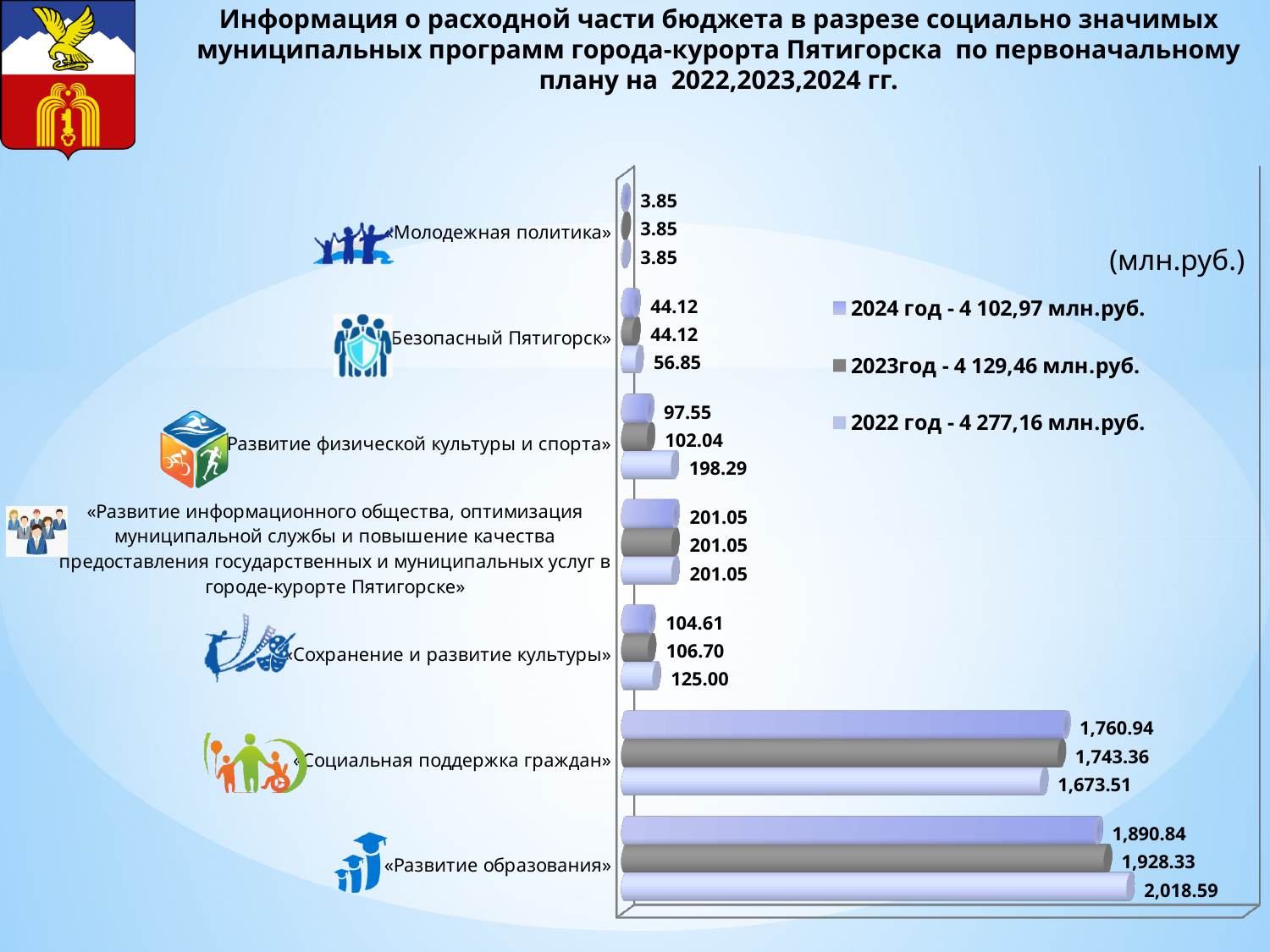
What is the 2024 value for «Социальная поддержка граждан»? 1,760.94 How many programs (categories) are shown in the chart? 7 What is the 2022 value for «Безопасный Пятигорск»? 56.85 Which program has the lowest 2024 value? «Молодежная политика» What is the difference between the 2022 and 2024 values for «Развитие физической культуры и спорта»? 100.74 What kind of chart is shown on the slide? Bar chart What is the 2022 value for «Развитие образования»? 2,018.59 According to the legend, what is the total for 2023? 4 129,46 млн.руб. Which is larger for «Развитие образования»: the 2023 value or the 2024 value? 2023 How many series does the legend list? 3 Which program has the highest 2022 value? «Развитие образования» What is the 2023 value for «Сохранение и развитие культуры»? 106.70